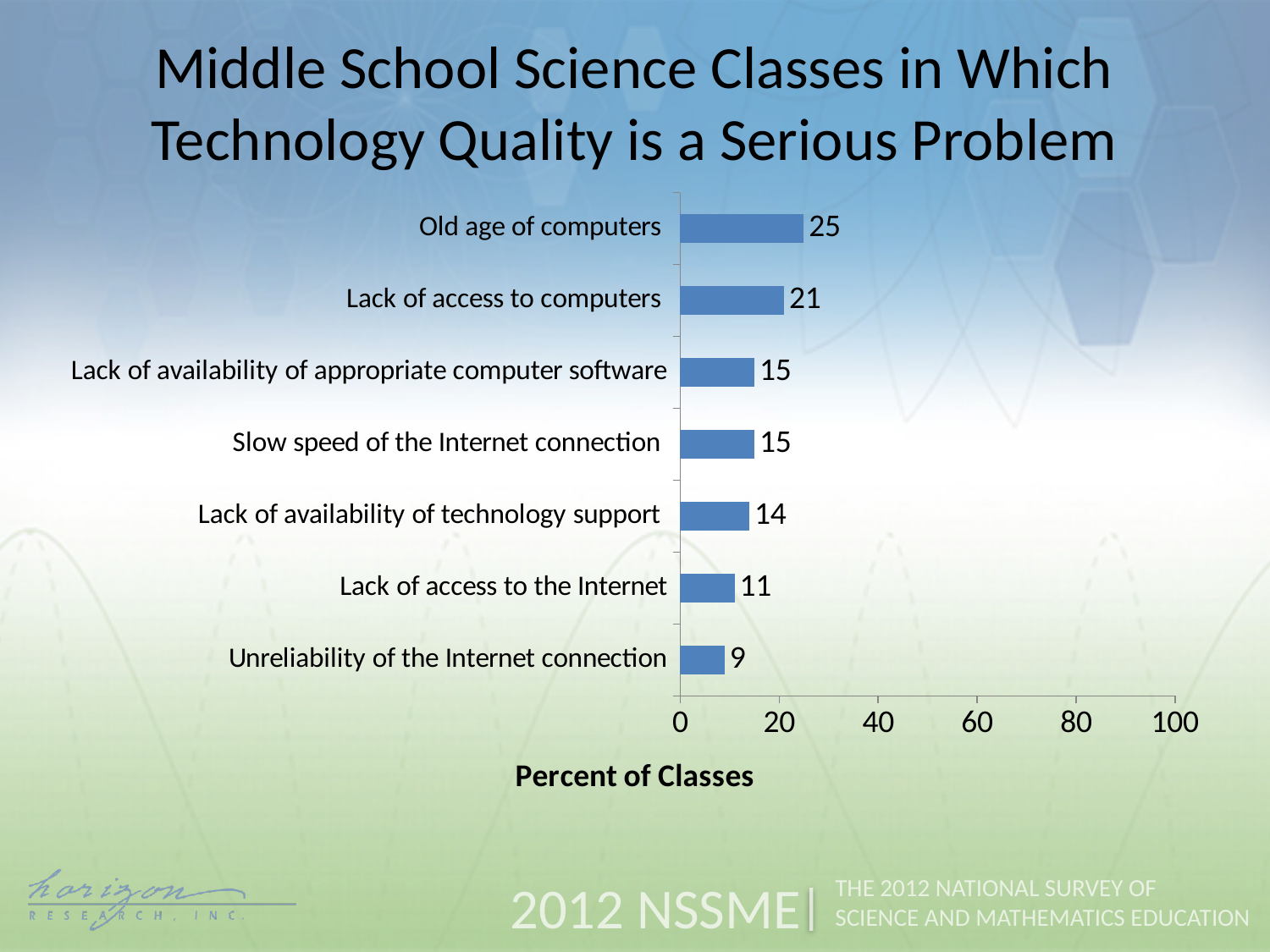
Which is larger: the value for lack of access to computers or the value for slow speed of the Internet connection? Lack of access to computers Which category has the highest value? Old age of computers What kind of chart is shown on the slide? Bar chart What is the value for lack of availability of technology support? 14 What is the difference between the values for old age of computers and lack of access to computers? 4 What percent of classes report old age of computers as a serious problem? 25 What is the value for lack of access to the Internet? 11 Is the value for old age of computers greater or less than 20? greater Which category has the lowest value? Unreliability of the Internet connection How many categories are shown in the chart? 7 What is the difference between the values for lack of access to the Internet and unreliability of the Internet connection? 2 What is the label of the horizontal axis? Percent of Classes